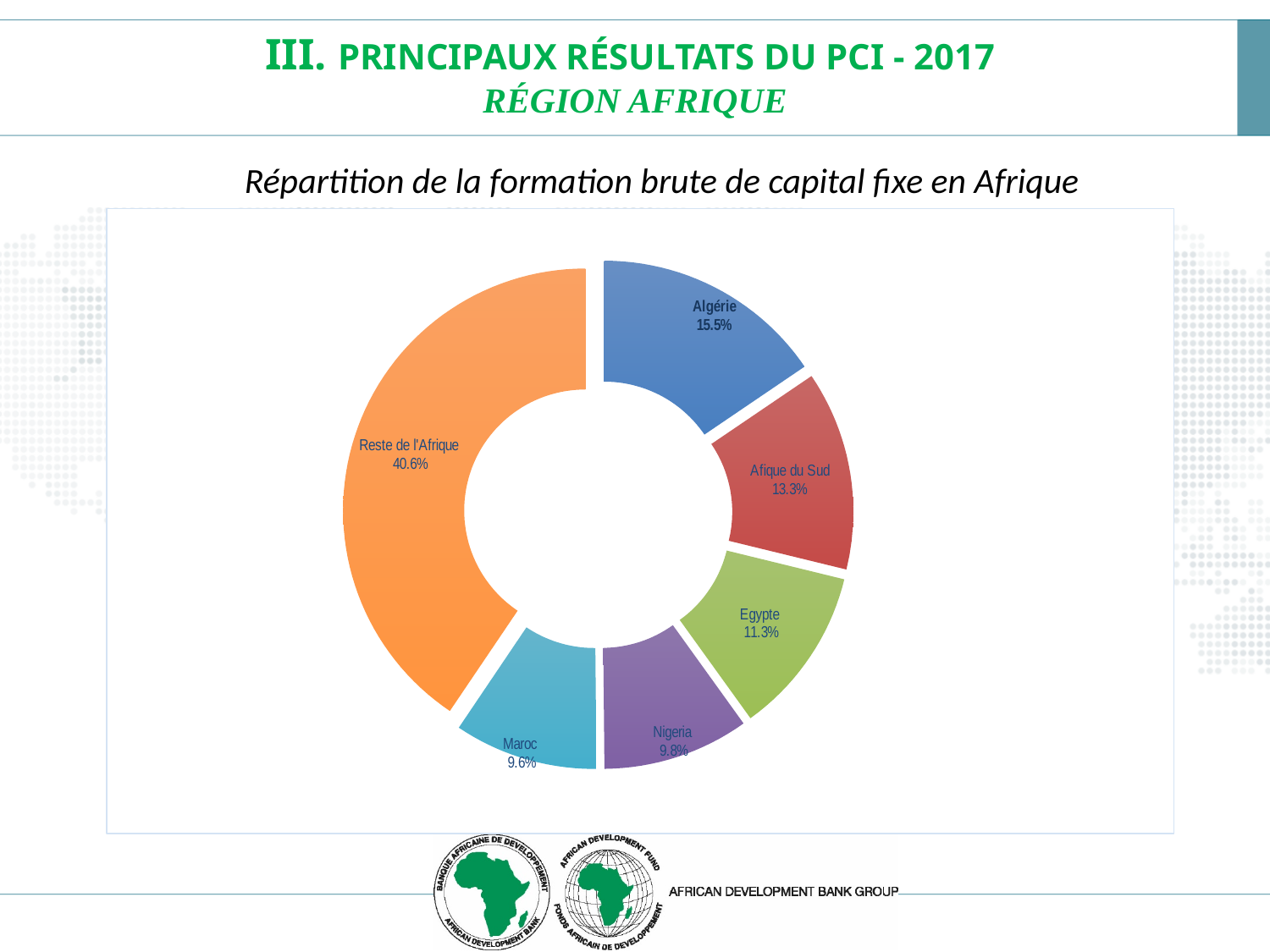
Which has a larger share, Egypte or Nigeria? Egypte What is the title of the chart? Répartition de la formation brute de capital fixe en Afrique What share of gross fixed capital formation in Africa does Algérie account for? 15.5% How many slices does the chart have? 6 Which category has the largest share of the chart? Reste de l'Afrique Which named country has the smallest share? Maroc What percentage is shown for Egypte? 11.3% What kind of chart is shown on the slide? Doughnut (pie) chart What is the value shown for Afique du Sud? 13.3% What is the difference between the shares of Algérie and Afique du Sud? 2.2% What is the value shown for Nigeria? 9.8% What share is shown for Maroc? 9.6%